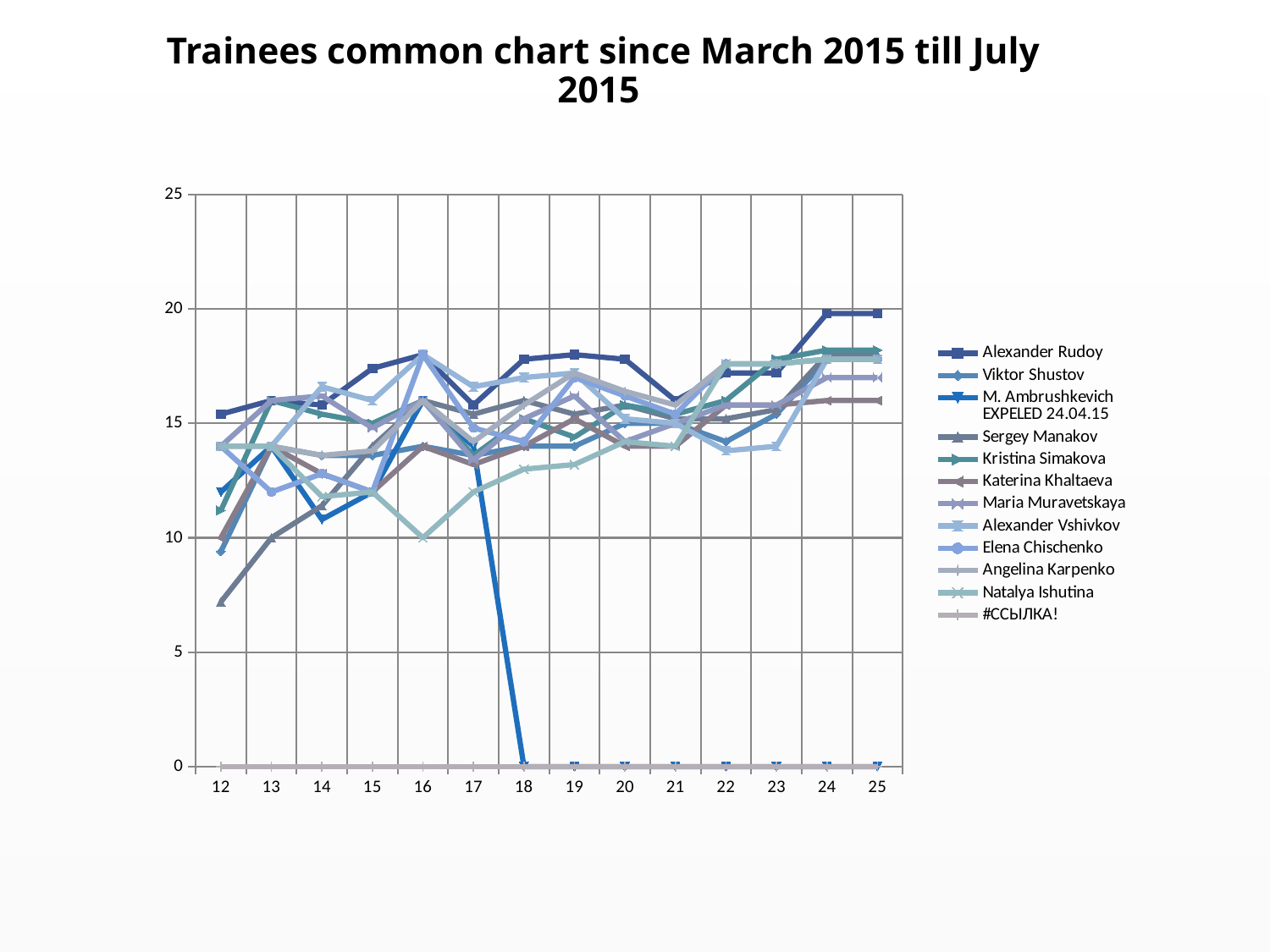
Which series is highest at x = 25? Alexander Rudoy Is the value for M. Ambrushkevich EXPELED 24.04.15 at x = 18 greater or less than 5? less Does the Alexander Rudoy line rise or fall overall from x = 12 to x = 25? rise How many series does the legend list? 12 Is the value for Sergey Manakov at x = 12 greater or less than 10? less Is the value for Alexander Rudoy at x = 24 greater or less than 15? greater Which series drops to 0 at x = 18 and stays there? M. Ambrushkevich EXPELED 24.04.15 At x = 12, which is larger: Alexander Rudoy or Sergey Manakov? Alexander Rudoy What kind of chart is shown on the slide? line chart What is the title of the chart? Trainees common chart since March 2015 till July 2015 How many points are there along the x axis? 14 Which series is highest at x = 24? Alexander Rudoy